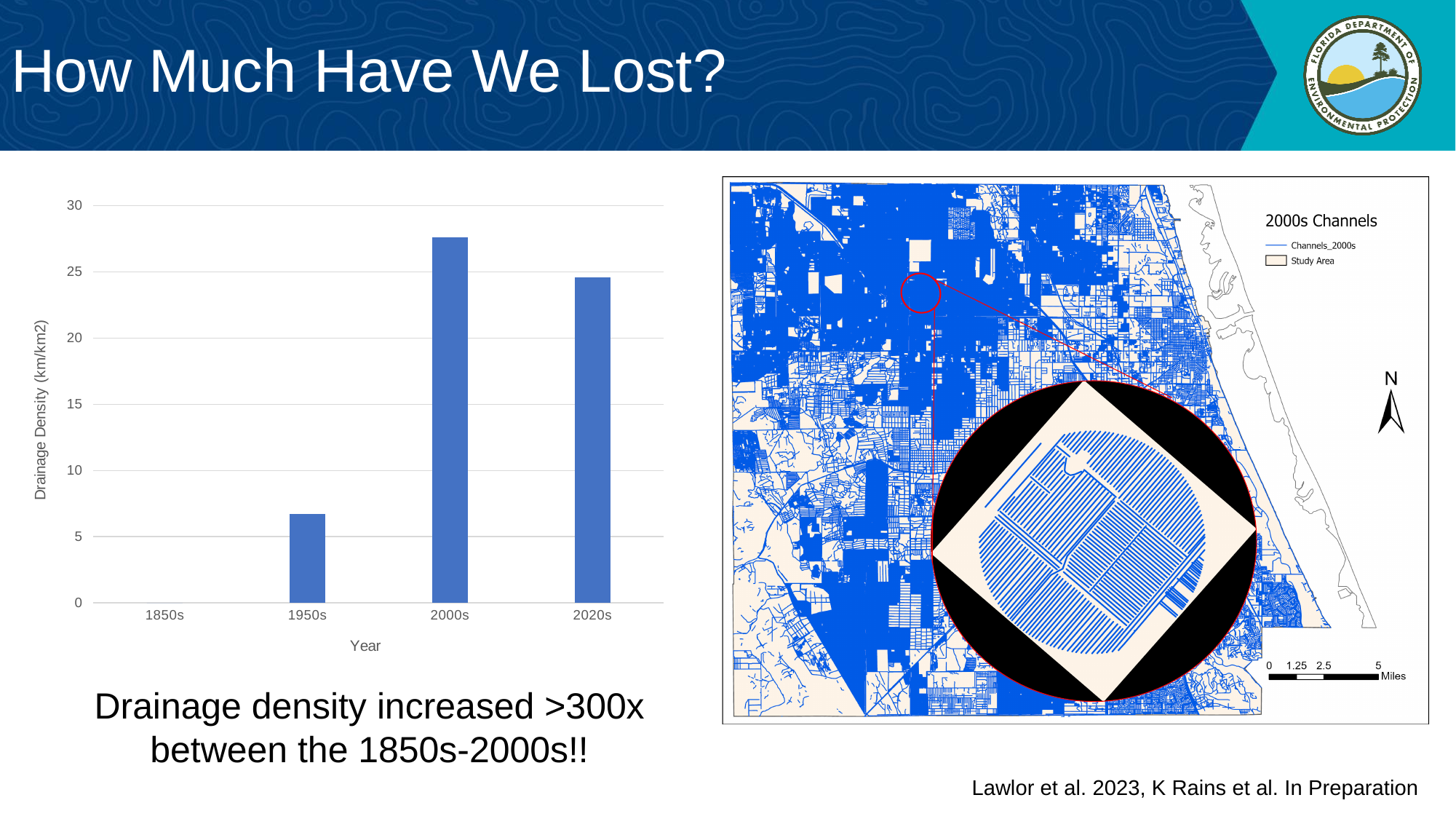
What kind of chart is shown on the left of the slide? bar chart In the bar chart, which is larger, the drainage density for the 2000s or the 2020s? 2000s Which year category has the highest drainage density in the bar chart? 2000s In the bar chart, which is larger, the drainage density for the 1950s or the 2020s? 2020s Is the drainage density for the 2000s greater or less than 25? greater Is the drainage density for the 2020s greater or less than 20? greater Is the drainage density for the 1950s greater or less than 10? less Does the drainage density rise or fall from the 2000s to the 2020s in the bar chart? fall What is the label on the y axis of the bar chart? Drainage Density (km/km2) How many year categories are shown on the x axis of the bar chart? 4 Which year category has the lowest drainage density in the bar chart? 1850s